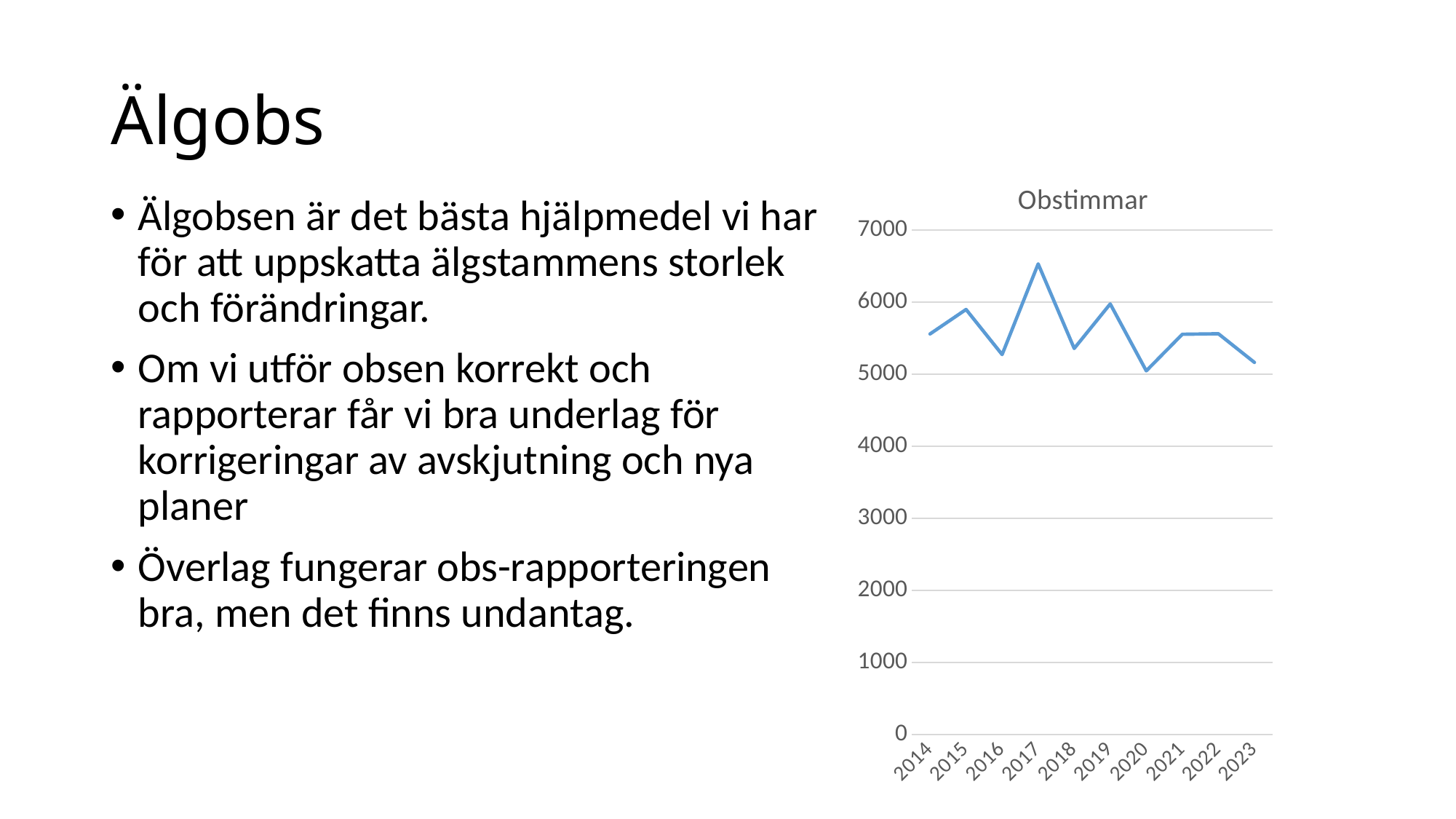
What is the title of the chart? Obstimmar Is the value for 2018 greater or less than 6000? less Does the line rise or fall from 2016 to 2017? rise What kind of chart is shown on the slide? line chart Is the value for 2014 greater or less than 5000? greater Is the value for 2017 greater or less than 6000? greater Which is larger, the value for 2015 or the value for 2016? 2015 Which year has the lowest value in the Obstimmar chart? 2020 How many years are plotted on the x axis of the chart? 10 Which year has the highest value in the Obstimmar chart? 2017 Which is larger, the value for 2017 or the value for 2018? 2017 Does the line rise or fall from 2019 to 2020? fall